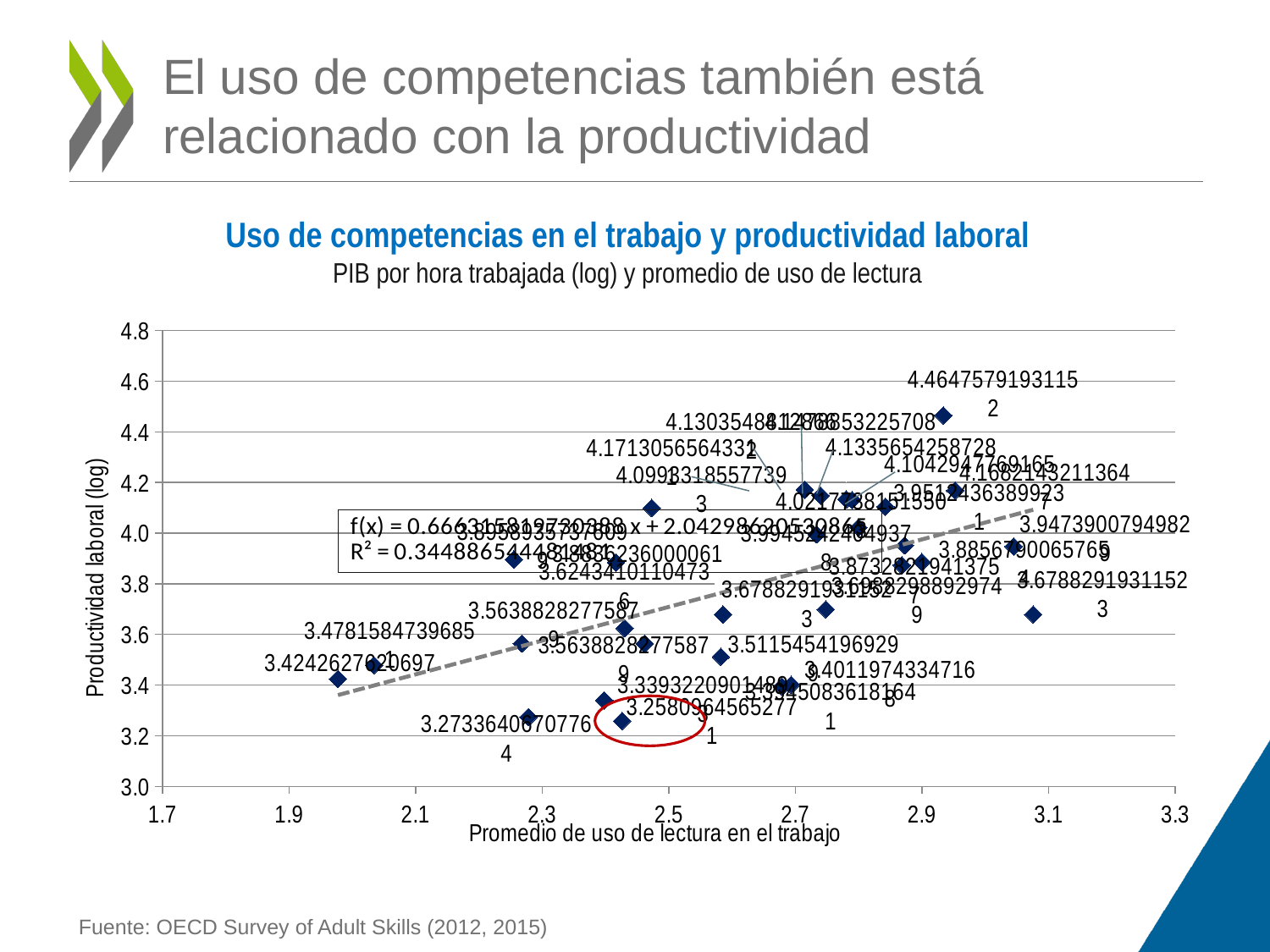
What is the label of the vertical axis of the chart? Productividad laboral (log) Is the value of the point circled in red greater or less than 3.4? less What is the title of the chart? Uso de competencias en el trabajo y productividad laboral Is the value of the point circled in red greater or less than 3.2? greater What kind of chart is shown on the slide? scatter chart Which is larger: the value of the highest point near 2.9 on the x axis or the value of the leftmost point near 2.0? the point near 2.9 Do the plotted values generally rise or fall as the reading-use score on the x axis increases? rise What is the highest productivity value labelled on the chart? 4.46475791931152 Is the rightmost point (near 3.1 on the x axis) greater or less than 3.8? less